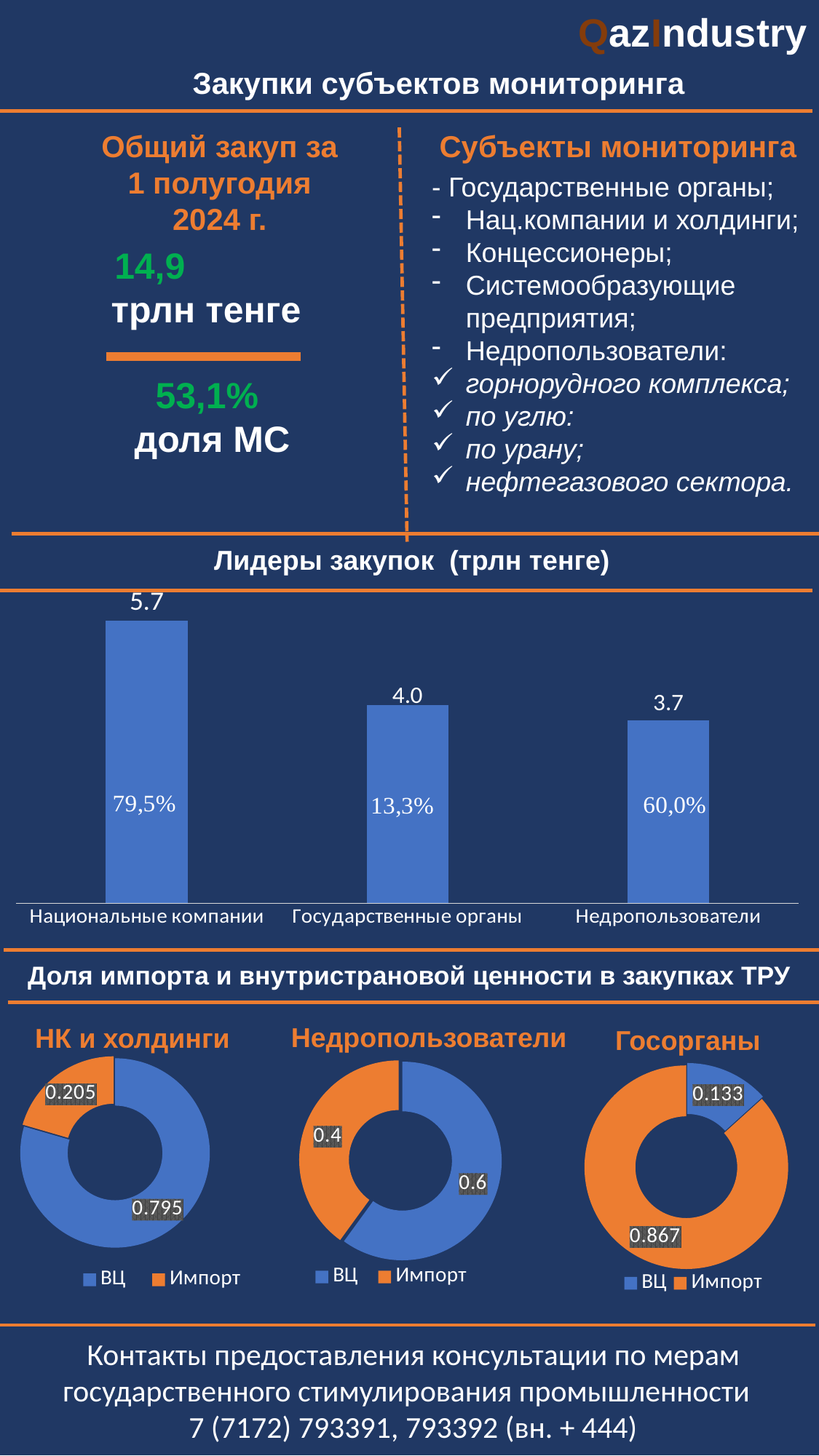
What type of chart is 'Лидеры закупок (трлн тенге)'? bar chart How many series does the legend of the donut chart 'Госорганы' list? 2 In the donut chart 'НК и холдинги', what is the value for Импорт? 0.205 In the bar chart 'Лидеры закупок (трлн тенге)', what is the difference between the values for Национальные компании and Государственные органы? 1.7 How many bars are in the bar chart 'Лидеры закупок (трлн тенге)'? 3 In the donut chart 'Госорганы', what is the value for ВЦ? 0.133 In the bar chart 'Лидеры закупок (трлн тенге)', what is the value for Недропользователи? 3.7 In the bar chart 'Лидеры закупок (трлн тенге)', which category has the highest value? Национальные компании In the bar chart 'Лидеры закупок (трлн тенге)', what percentage is printed inside the bar for Государственные органы? 13,3% In the donut chart 'Недропользователи', which is larger, ВЦ or Импорт? ВЦ In the bar chart 'Лидеры закупок (трлн тенге)', what is the value for Национальные компании? 5.7 In the bar chart 'Лидеры закупок (трлн тенге)', which category has the lowest value? Недропользователи